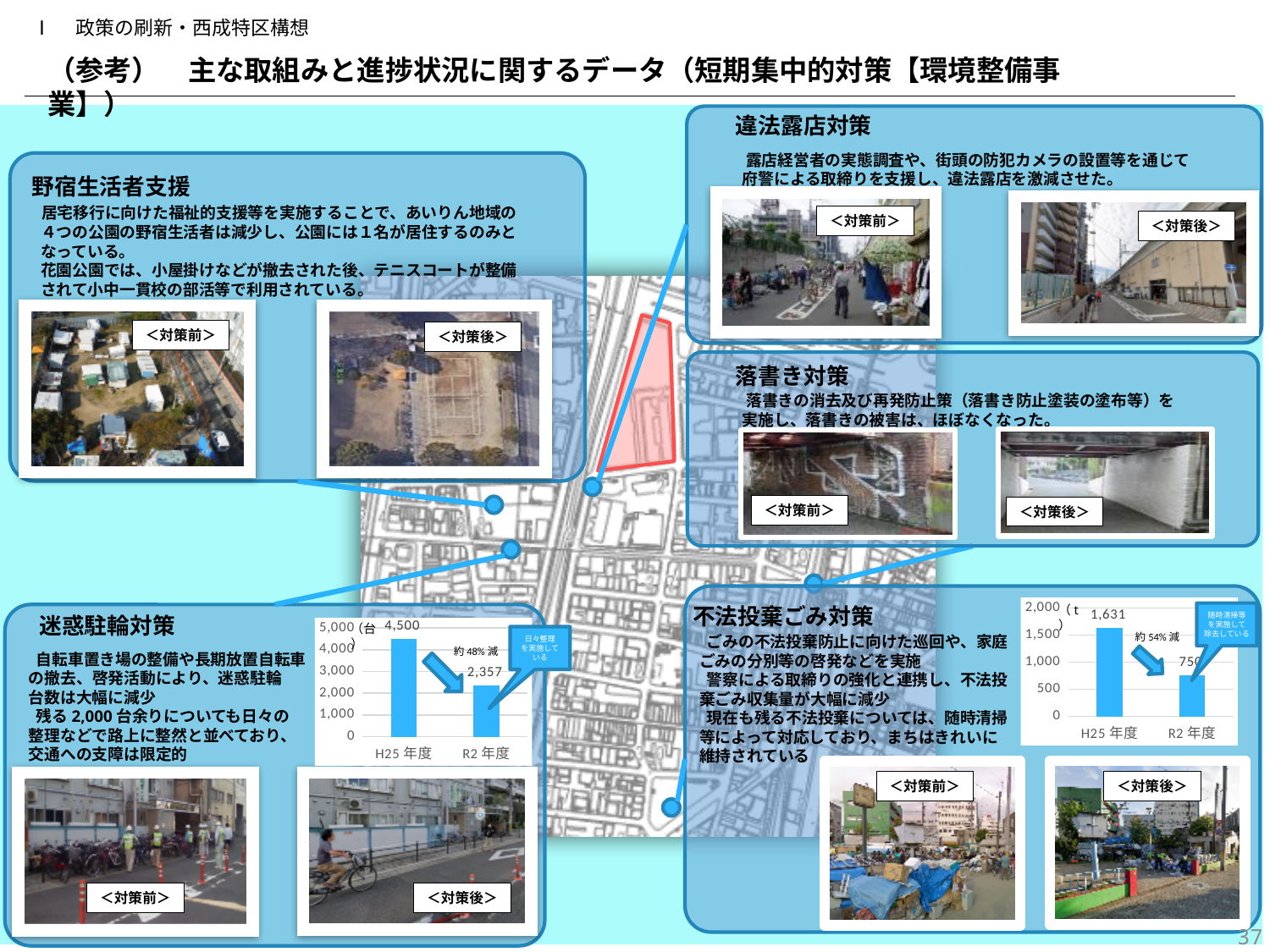
In the bar chart in the 不法投棄ごみ対策 section (bottom right), do the values rise or fall from H25 年度 to R2 年度? fall In the bar chart in the 迷惑駐輪対策 section (bottom left), what percentage reduction is annotated between the two bars? 約48%減 In the bar chart in the 不法投棄ごみ対策 section (bottom right), which year has the lower value? R2 年度 In the bar chart in the 不法投棄ごみ対策 section (bottom right), what is the difference between the H25 年度 and R2 年度 values? 881 What type of chart is shown in the 迷惑駐輪対策 section (bottom left)? bar chart In the bar chart in the 迷惑駐輪対策 section (bottom left), what is the value for R2 年度? 2,357 In the bar chart in the 迷惑駐輪対策 section (bottom left), what is the value for H25 年度? 4,500 In the bar chart in the 不法投棄ごみ対策 section (bottom right), what is the value for H25 年度? 1,631 How many categories are shown on the x axis of the bar chart in the 不法投棄ごみ対策 section (bottom right)? 2 In the bar chart in the 迷惑駐輪対策 section (bottom left), what is the difference between the H25 年度 and R2 年度 values? 2,143 In the bar chart in the 迷惑駐輪対策 section (bottom left), which year has the higher value? H25 年度 In the bar chart in the 不法投棄ごみ対策 section (bottom right), what is the value for R2 年度? 750